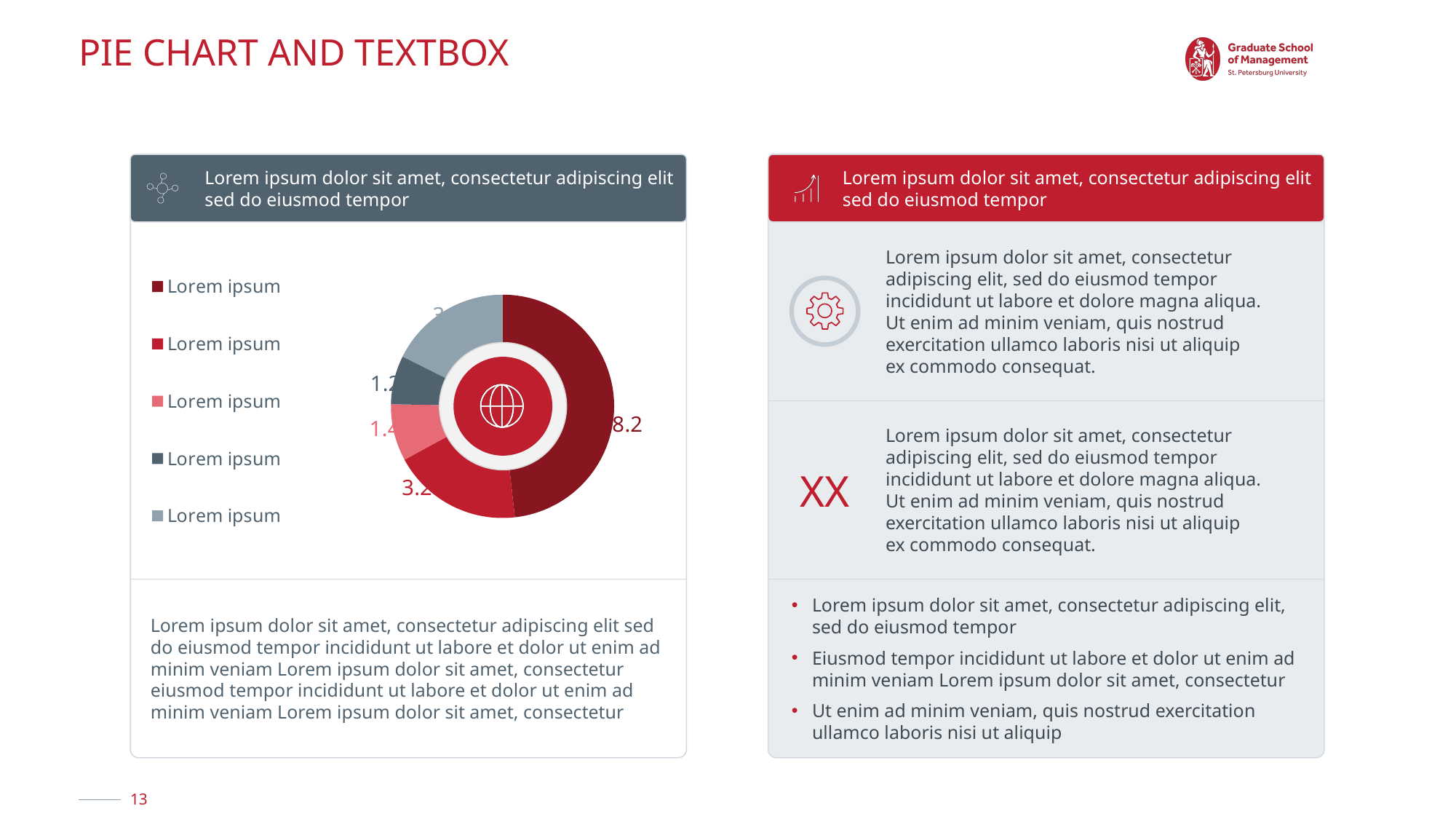
What is the difference between the dark red slice (8.2) and the bright red slice (3.2) in the pie chart? 5 Which slice of the pie chart has the highest value? the dark red slice (8.2) What text is used for every entry in the pie chart's legend? Lorem ipsum What kind of chart is shown on the slide? pie chart How many entries does the pie chart's legend list? 5 What colour is the largest slice of the pie chart? dark red Which is larger in the pie chart: the dark red slice or the bright red slice? the dark red slice How many slices does the pie chart have? 5 What is the value shown on the bright red slice of the pie chart? 3.2 What is the value shown on the largest (dark red) slice of the pie chart? 8.2